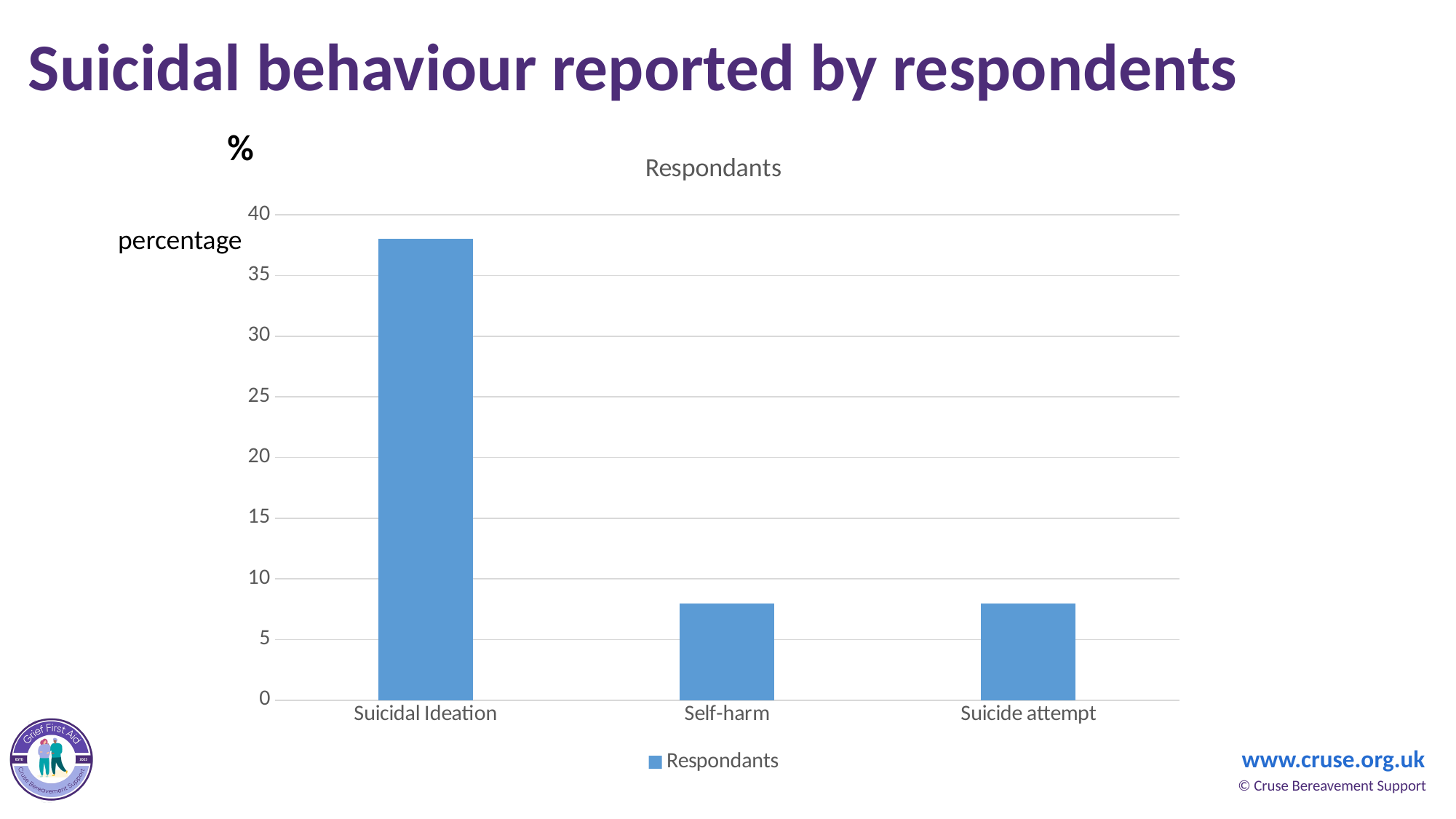
How many series does the chart's legend list? 1 Is the value for Suicidal Ideation greater or less than 35? greater Is the value for Self-harm greater or less than 10? less Is the value for Suicidal Ideation greater or less than 40? less Which is larger, the value for Suicidal Ideation or the value for Self-harm? Suicidal Ideation How many categories are shown on the x axis of the chart? 3 Which is larger, the value for Suicide attempt or the value for Suicidal Ideation? Suicidal Ideation What kind of chart is shown on the slide? bar chart Which category has the highest value in the chart? Suicidal Ideation What is the name of the series listed in the chart's legend? Respondants What is the title shown above the chart's plot area? Respondants